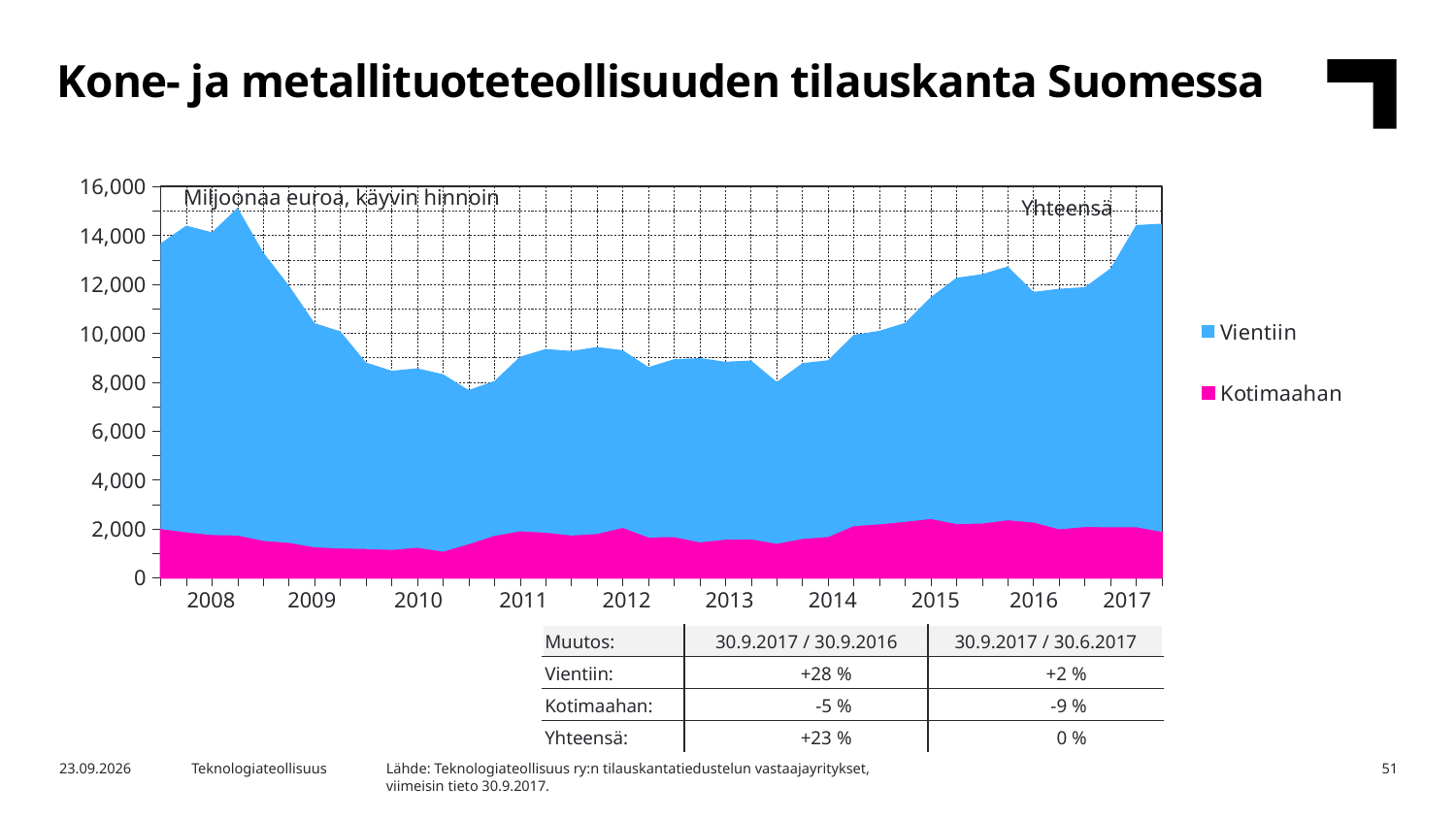
Does the total order book (Yhteensä) rise or fall between 2014 and 2017? rise Which series is larger throughout the chart, Vientiin or Kotimaahan? Vientiin Is the total (Yhteensä) value in 2013 greater or less than 10,000? less Does the total order book (Yhteensä) rise or fall between 2008 and 2010? fall How many series does the chart legend list? 2 What unit is stated inside the chart area? Miljoonaa euroa, käyvin hinnoin How many years are labelled on the x axis of the chart? 10 Is the total (Yhteensä) value at the start of 2008 greater or less than 12,000? greater What kind of chart is shown on the slide? Area chart Is the total (Yhteensä) value at the end of 2017 greater or less than 12,000? greater What are the two series named in the chart legend? Vientiin and Kotimaahan